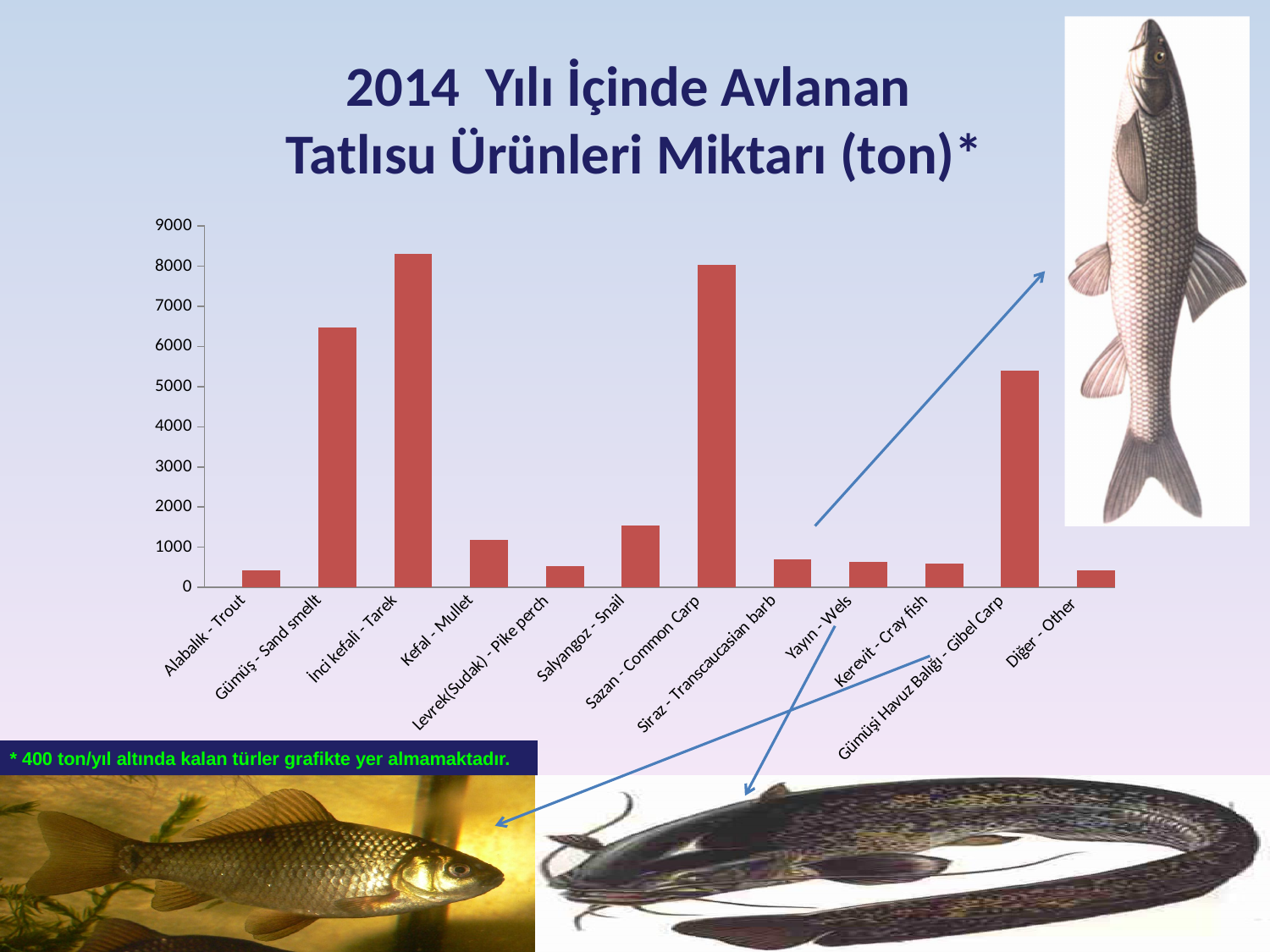
Which is larger, the value for Gümüş - Sand smelt or the value for Gümüşi Havuz Balığı - Gibel Carp? Gümüş - Sand smelt Is the value for Salyangoz - Snail greater or less than 1000? greater What kind of chart is shown on the slide? bar chart Is the value for Gümüş - Sand smelt greater or less than 6000? greater Which category has the highest value on the chart? İnci kefali - Tarek What is the title of the chart? 2014 Yılı İçinde Avlanan Tatlısu Ürünleri Miktarı (ton)* What colour are the bars in the chart? red Which is larger, the value for İnci kefali - Tarek or the value for Sazan - Common Carp? İnci kefali - Tarek Is the value for Alabalık - Trout greater or less than 1000? less How many fish/product categories are plotted on the chart? 12